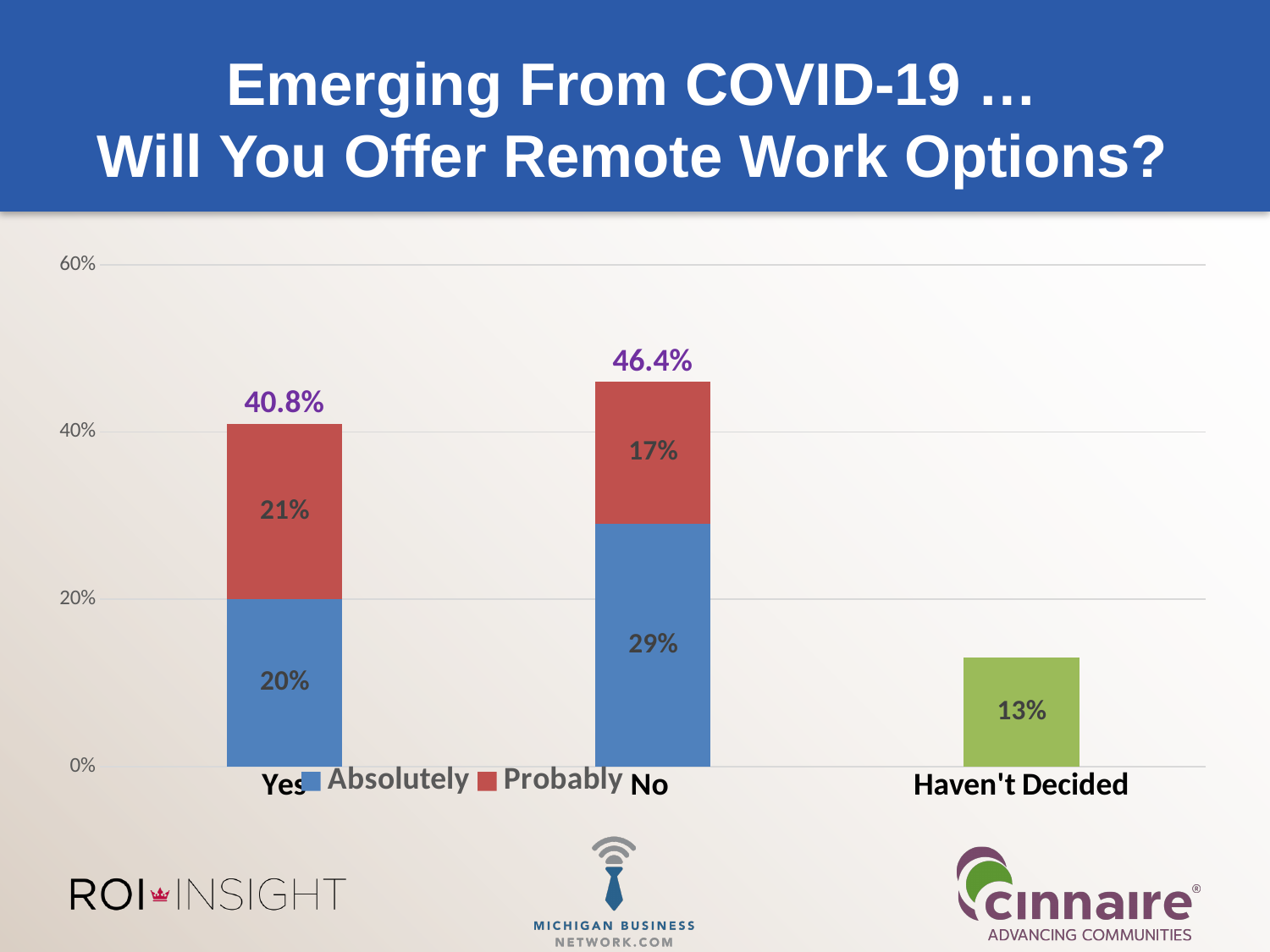
What is the Absolutely value for the Yes category? 20% What total is printed above the Yes bar? 40.8% Which category has the tallest bar overall? No What total is printed above the No bar? 46.4% What is the Probably value for the Yes category? 21% What is the difference between the Absolutely values for No and Yes? 9% What is the Probably value for the No category? 17% How many series does the legend list? 2 What kind of chart is shown on the slide? Stacked bar chart What value is shown for the Haven't Decided category? 13% What is the Absolutely value for the No category? 29% Which category has the shortest bar overall? Haven't Decided